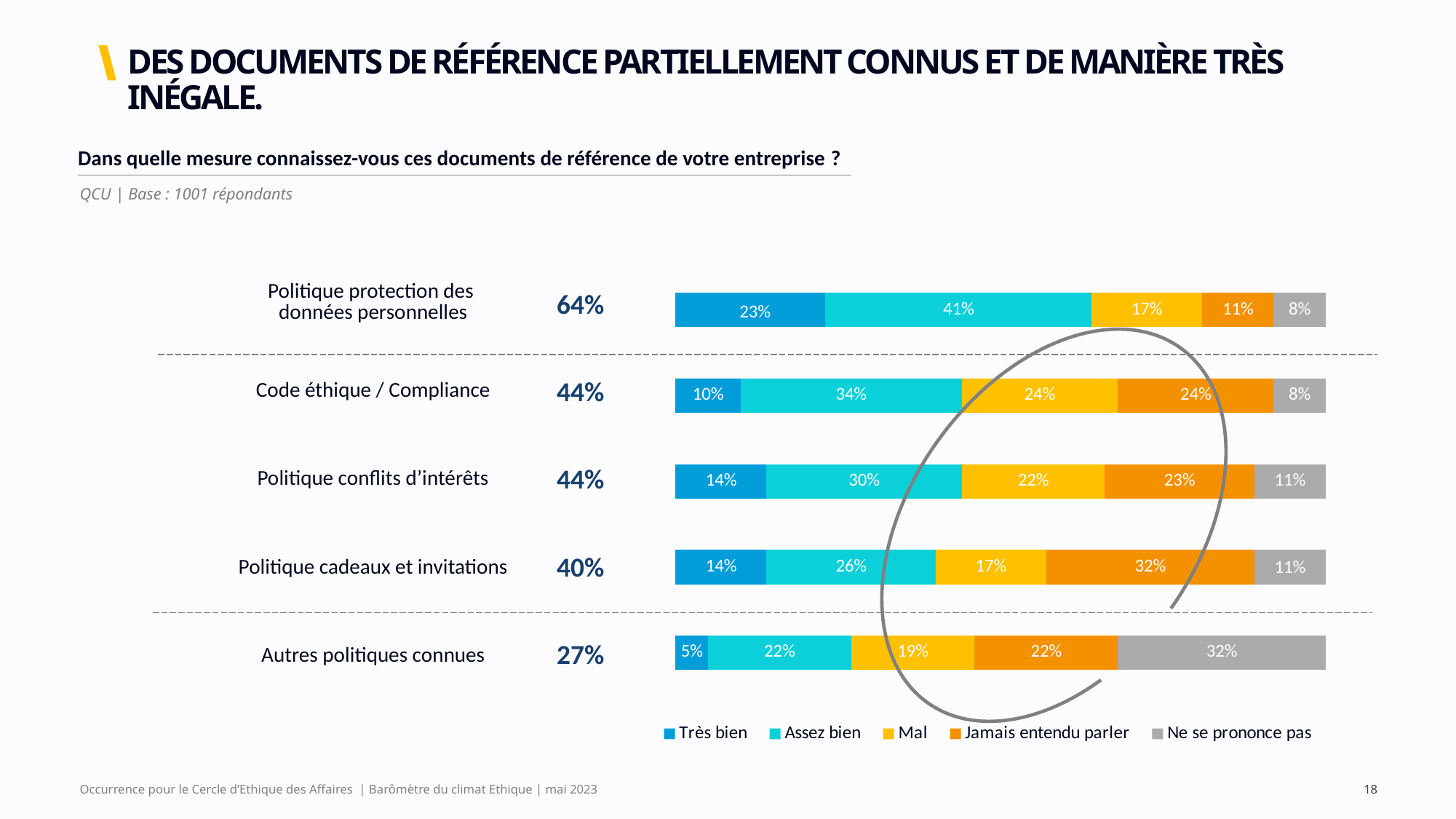
What is the 'Très bien' value for 'Politique protection des données personnelles'? 23% What kind of chart is shown on the slide? Stacked bar chart What is the 'Mal' value for 'Politique conflits d'intérêts'? 22% Which category has the lowest 'Très bien' value? Autres politiques connues How many series does the legend list? 5 What is the 'Jamais entendu parler' value for 'Politique cadeaux et invitations'? 32% What is the combined 'Très bien' and 'Assez bien' total shown next to 'Politique conflits d'intérêts'? 44% What is the difference between the 'Assez bien' values for 'Code éthique / Compliance' and 'Politique cadeaux et invitations'? 8% Which category has the highest 'Assez bien' value? Politique protection des données personnelles Which is larger: the 'Jamais entendu parler' value for 'Code éthique / Compliance' or for 'Politique protection des données personnelles'? Code éthique / Compliance How many categories are shown in the chart? 5 What is the 'Ne se prononce pas' value for 'Autres politiques connues'? 32%